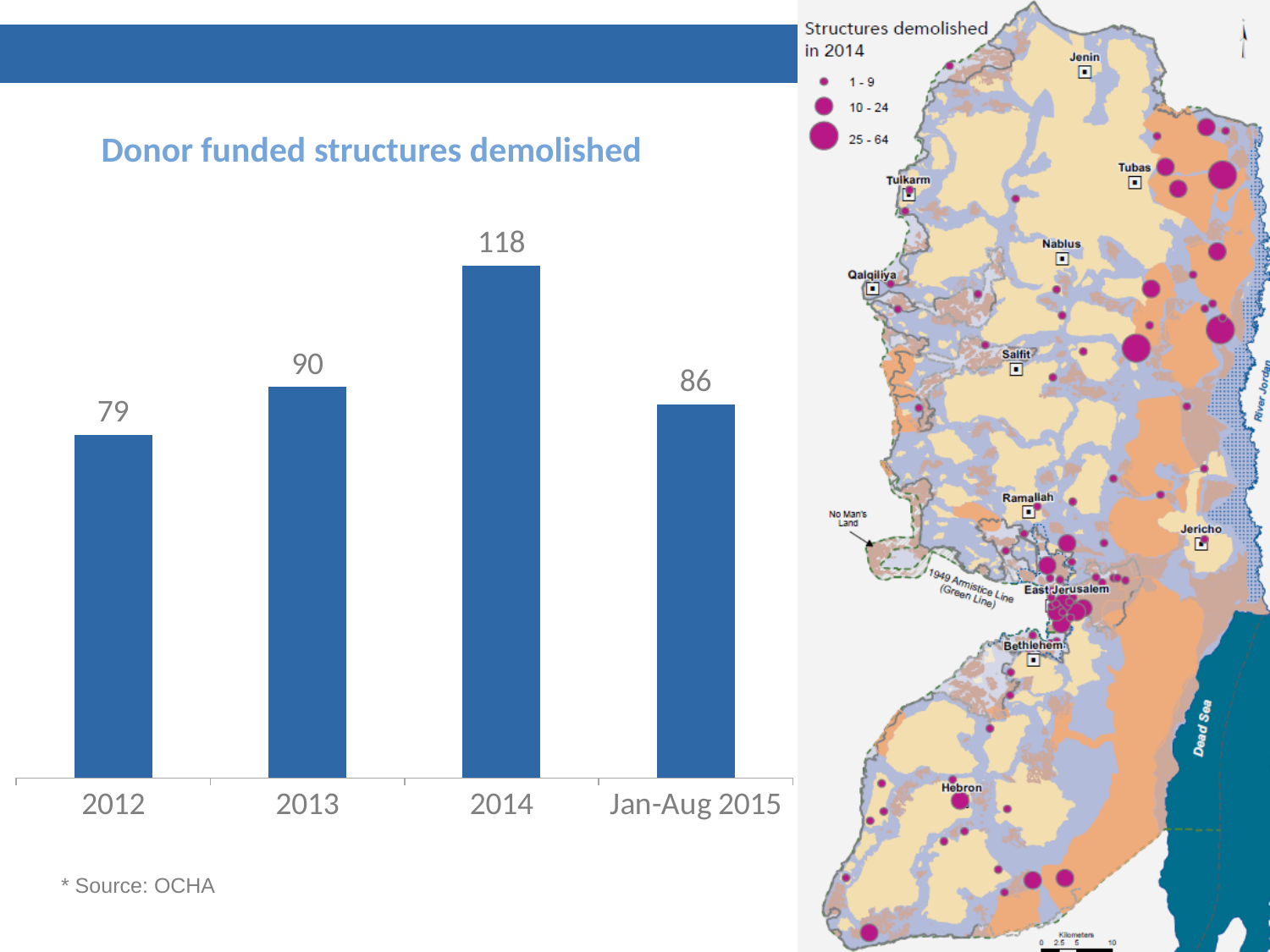
What is the difference between the 2014 and 2013 values in the 'Donor funded structures demolished' chart? 28 Which is larger in the 'Donor funded structures demolished' chart: 2013 or Jan-Aug 2015? 2013 What is the value for Jan-Aug 2015 in the 'Donor funded structures demolished' chart? 86 How many categories are shown on the x axis of the 'Donor funded structures demolished' chart? 4 Which category has the lowest value in the 'Donor funded structures demolished' chart? 2012 What is the value for 2014 in the 'Donor funded structures demolished' chart? 118 Which year has the highest value in the 'Donor funded structures demolished' chart? 2014 What is the value for 2012 in the 'Donor funded structures demolished' chart? 79 What is the difference between the Jan-Aug 2015 and 2012 values in the 'Donor funded structures demolished' chart? 7 What source is cited below the 'Donor funded structures demolished' chart? OCHA What kind of chart is 'Donor funded structures demolished'? bar chart Do the values in the 'Donor funded structures demolished' chart rise or fall from 2012 to 2014? rise